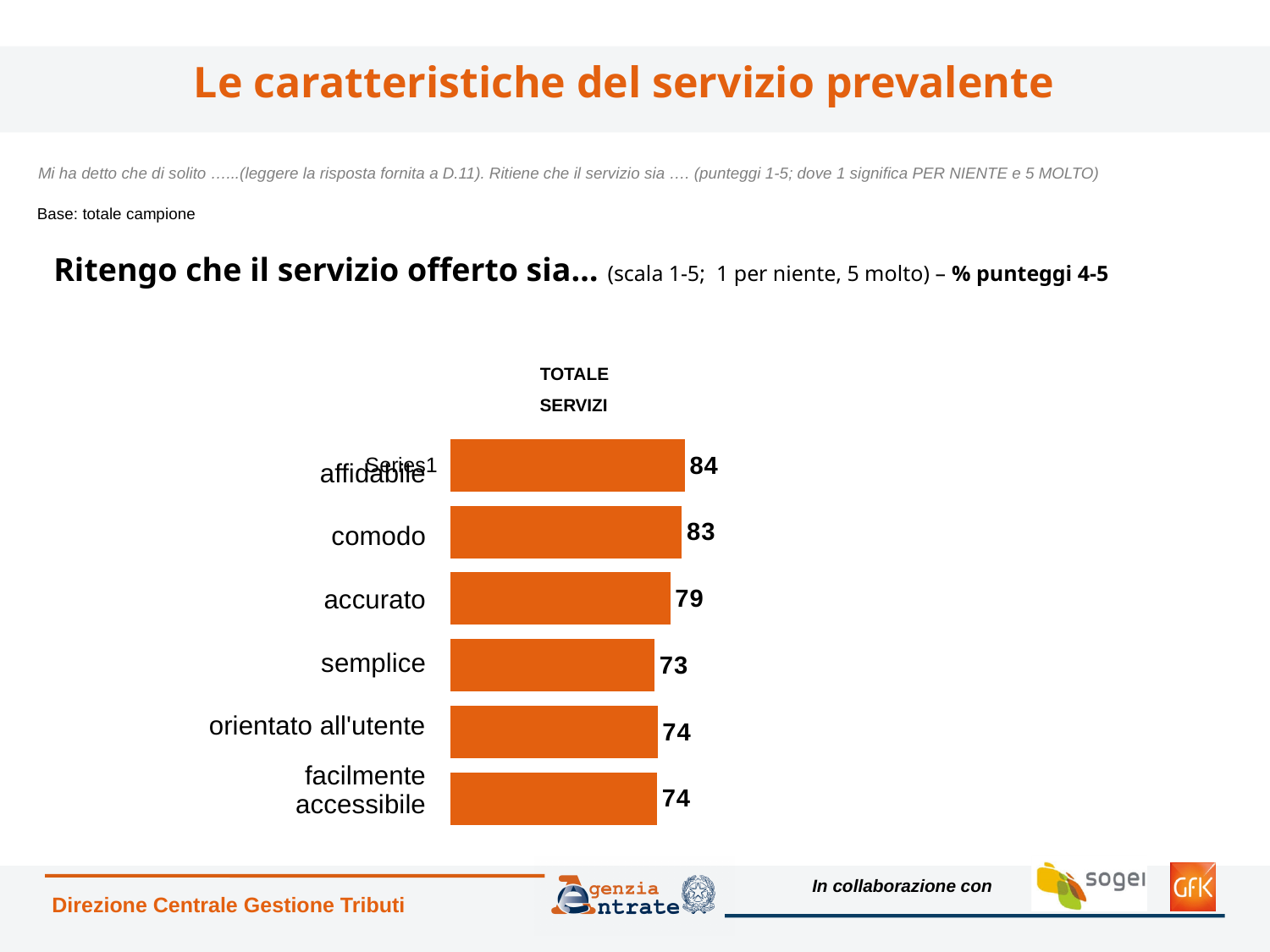
Which category has the lowest value? semplice What is the value for "orientato all'utente"? 74 What is the value for "accurato"? 79 What is the value for "semplice"? 73 What is the value for "comodo"? 83 What is the value for "affidabile"? 84 Which category has the highest value? affidabile Which is larger, the value for "accurato" or the value for "facilmente accessibile"? accurato What is the difference between the values for "affidabile" and "semplice"? 11 What kind of chart is shown on the slide? bar chart What is the heading printed above the bars of the chart? TOTALE SERVIZI How many categories are shown in the chart? 6